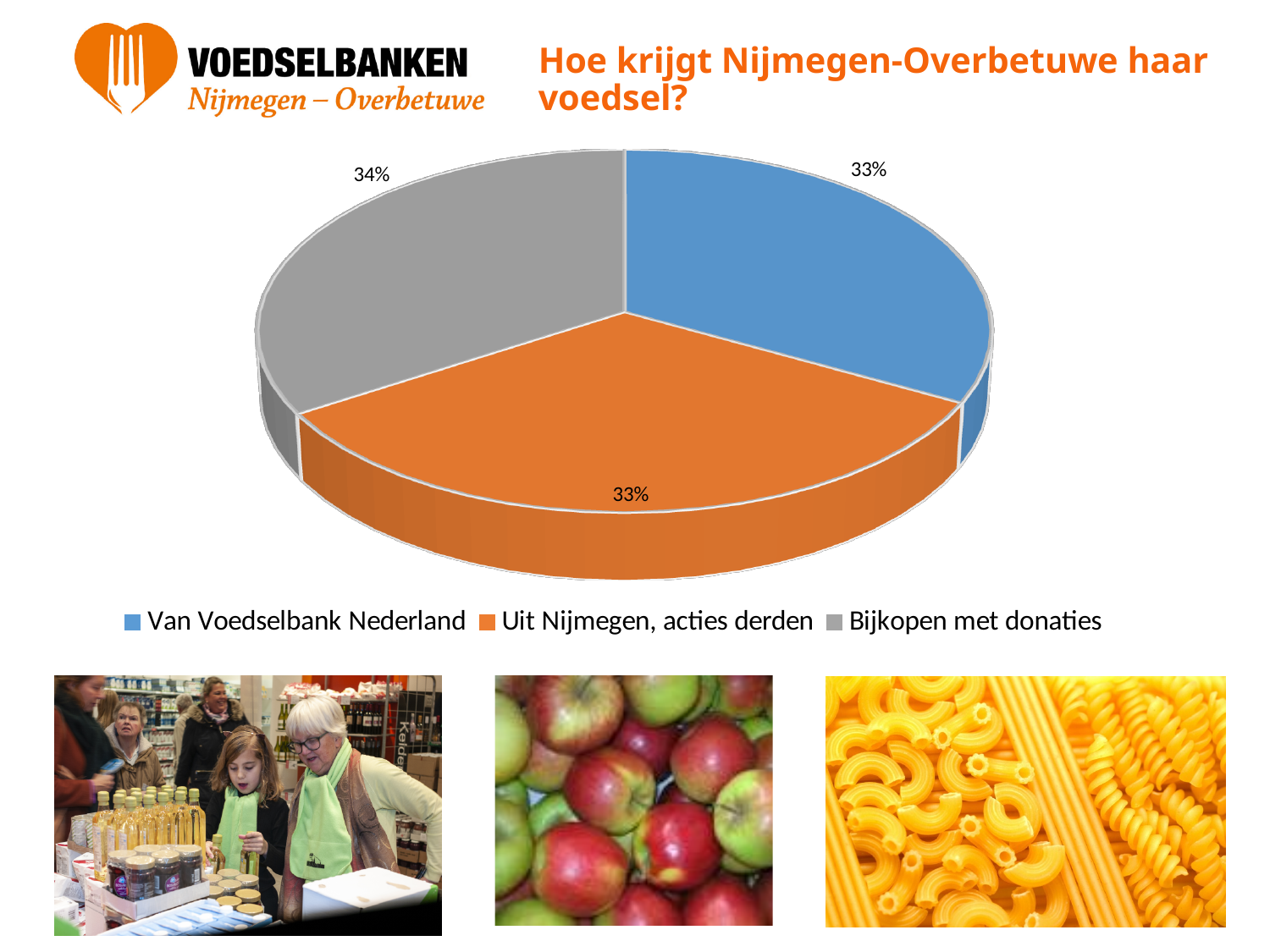
What share of the pie is labelled for Uit Nijmegen, acties derden? 33% Which category has the largest slice of the pie? Bijkopen met donaties What kind of chart is shown on the slide? pie chart What is the title of the chart? Hoe krijgt Nijmegen-Overbetuwe haar voedsel? How many slices does the pie chart have? 3 Which is larger: the slice for Bijkopen met donaties or the slice for Van Voedselbank Nederland? Bijkopen met donaties What share of the pie is labelled for Van Voedselbank Nederland? 33% How many entries does the legend list? 3 What share of the pie is labelled for Bijkopen met donaties? 34% Which category is shown in blue in the pie chart? Van Voedselbank Nederland What is the difference in percentage points between the Bijkopen met donaties slice and the Uit Nijmegen, acties derden slice? 1